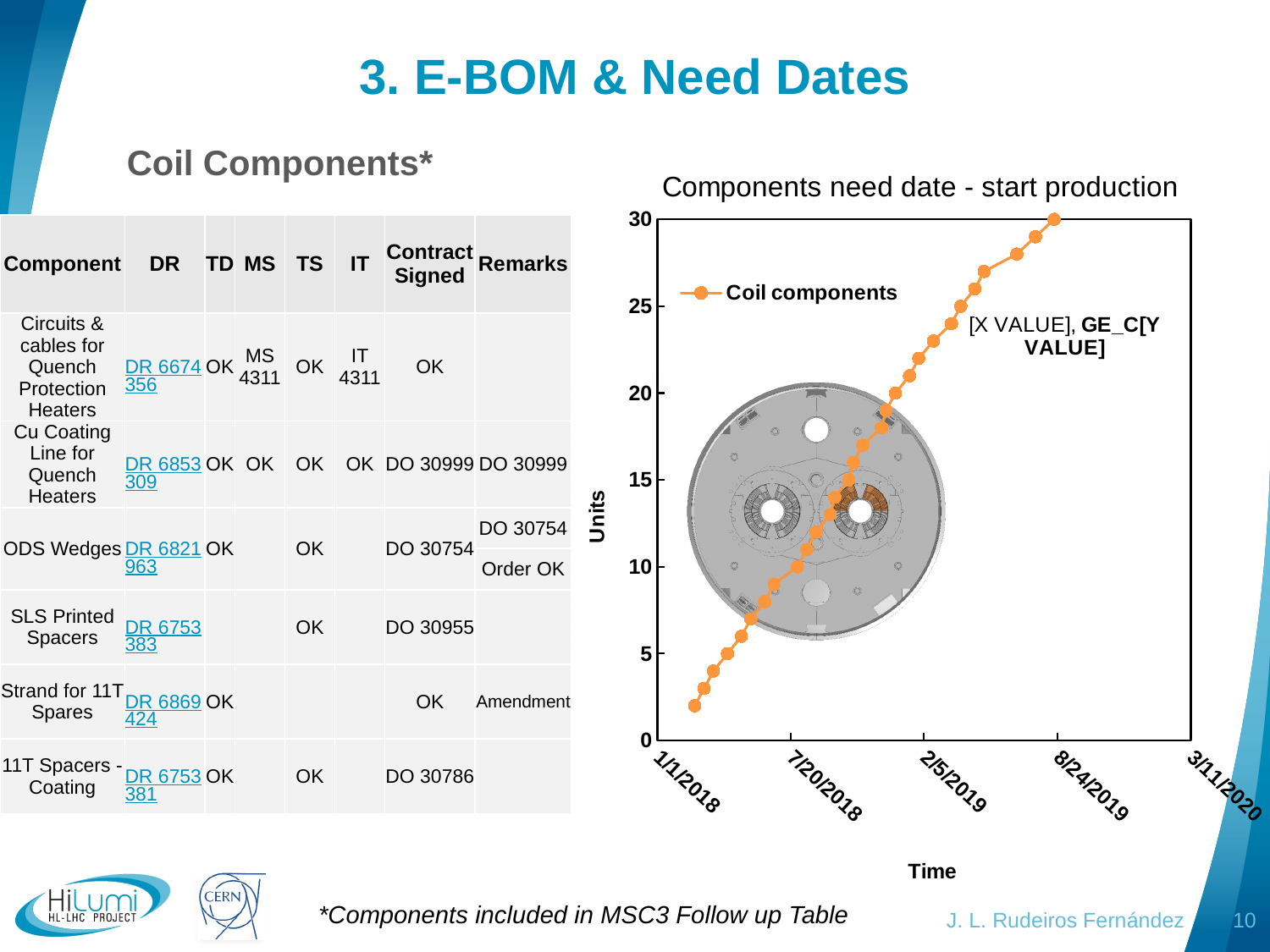
How many series does the chart legend list? 1 Is the value of the last Coil components point greater or less than 25 units? greater Is the value of the Coil components point at 2/5/2019 greater or less than 15 units? greater What is the name of the series shown in the chart legend? Coil components Is the value of the Coil components point at 7/20/2018 greater or less than 15 units? less What type of chart is shown on the slide? line chart What is the title of the chart on the slide? Components need date - start production Do the values of the Coil components series rise or fall along the x axis over time? rise What is the label of the y axis of the chart? Units How many date labels are shown on the x axis of the chart? 5